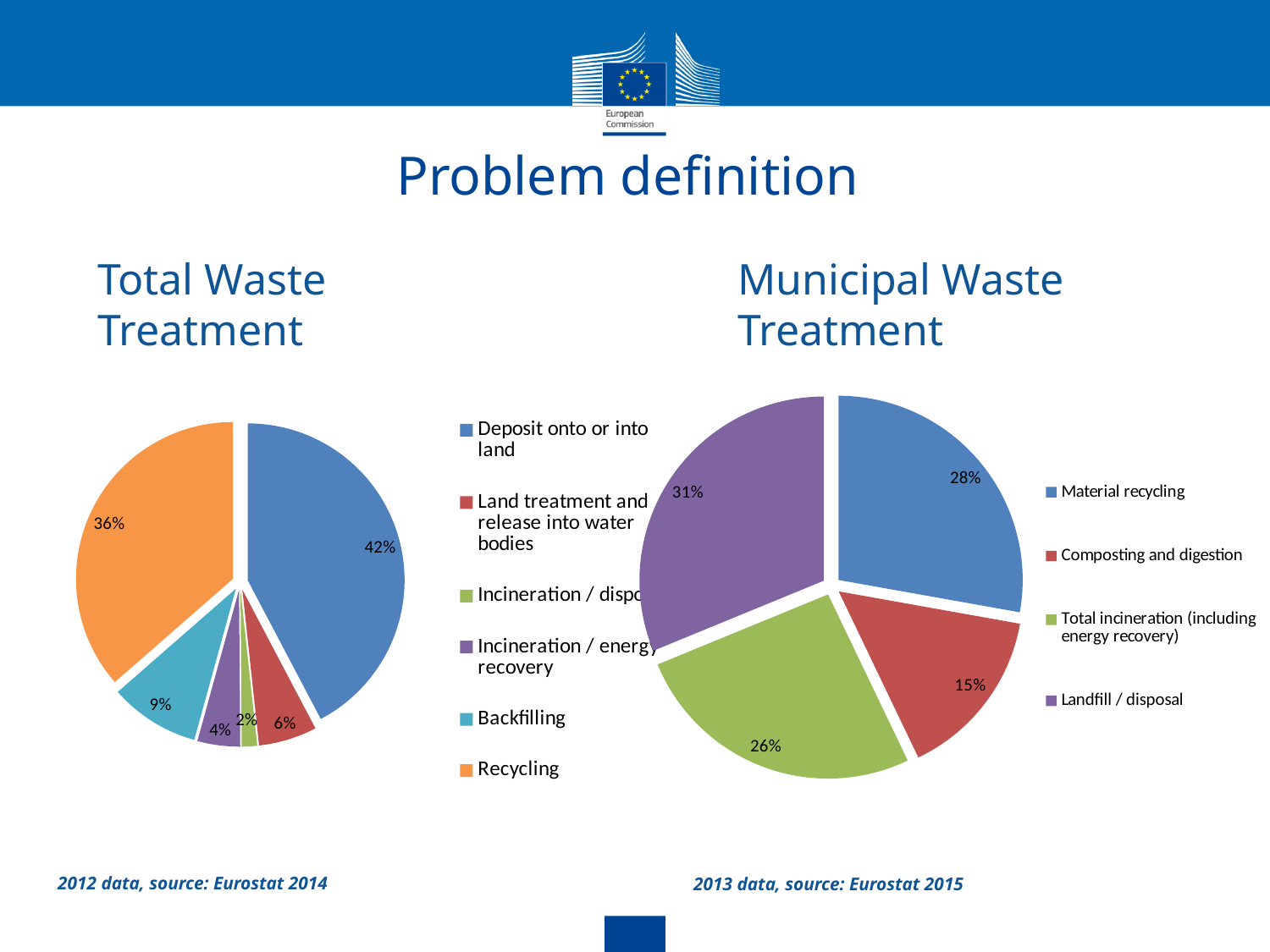
In the Municipal Waste Treatment chart, which is larger: Material recycling or Total incineration (including energy recovery)? Material recycling What type of chart is the Municipal Waste Treatment chart? Pie chart In the Municipal Waste Treatment chart, what share is Composting and digestion? 15% In the Municipal Waste Treatment chart, what share is Landfill / disposal? 31% In the Municipal Waste Treatment chart, which category has the smallest share? Composting and digestion In the Total Waste Treatment chart, what share is Backfilling? 9% In the Total Waste Treatment chart, what share is Deposit onto or into land? 42% In the Total Waste Treatment chart, what share is Recycling? 36% In the Municipal Waste Treatment chart, how many slices does the pie have? 4 In the Total Waste Treatment chart, which category has the largest share? Deposit onto or into land In the Total Waste Treatment chart, how many categories does the legend list? 6 In the Total Waste Treatment chart, what is the difference between the Deposit onto or into land share and the Recycling share? 6 percentage points